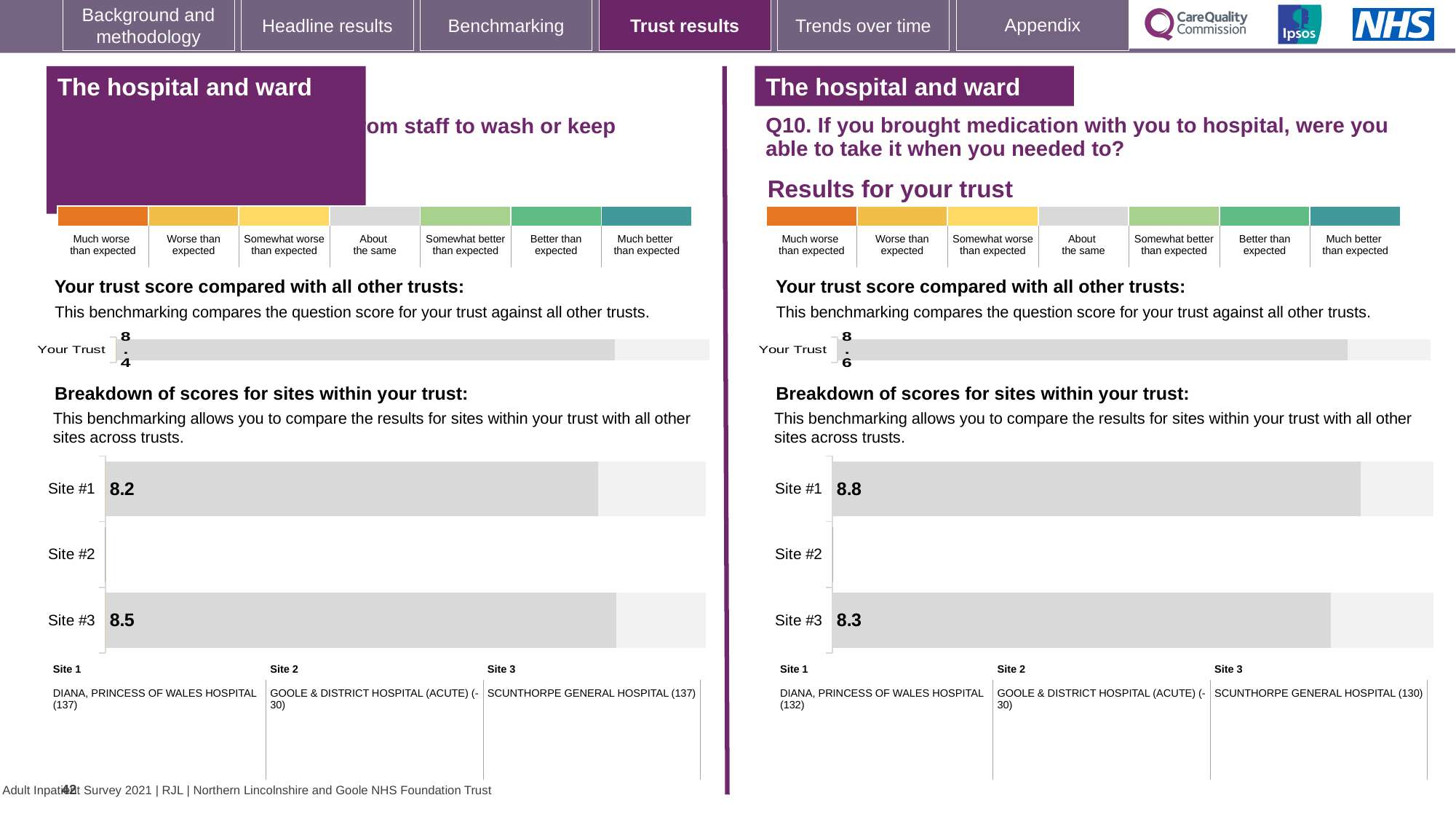
On the right-hand site breakdown chart (Q10), what is the score for Site #1? 8.8 On the left-hand site breakdown chart, what is the difference between the Site #3 and Site #1 scores? 0.3 On the right-hand site breakdown chart (Q10), which site has the highest score? Site #1 On the left-hand chart, what is the score for Your Trust? 8.4 What type of chart is used for the site breakdown on the right-hand side (Q10)? Bar chart On the right-hand site breakdown chart (Q10), what is the score for Site #3? 8.3 On the left-hand site breakdown chart, what is the score for Site #1? 8.2 On the left-hand site breakdown chart, what is the score for Site #3? 8.5 On the right-hand site breakdown chart (Q10), what is the difference between the Site #1 and Site #3 scores? 0.5 On the right-hand chart (Q10, medication), what is the score for Your Trust? 8.6 How many site categories are listed on the right-hand site breakdown chart (Q10)? 3 On the left-hand site breakdown chart, which site has the higher score, Site #1 or Site #3? Site #3